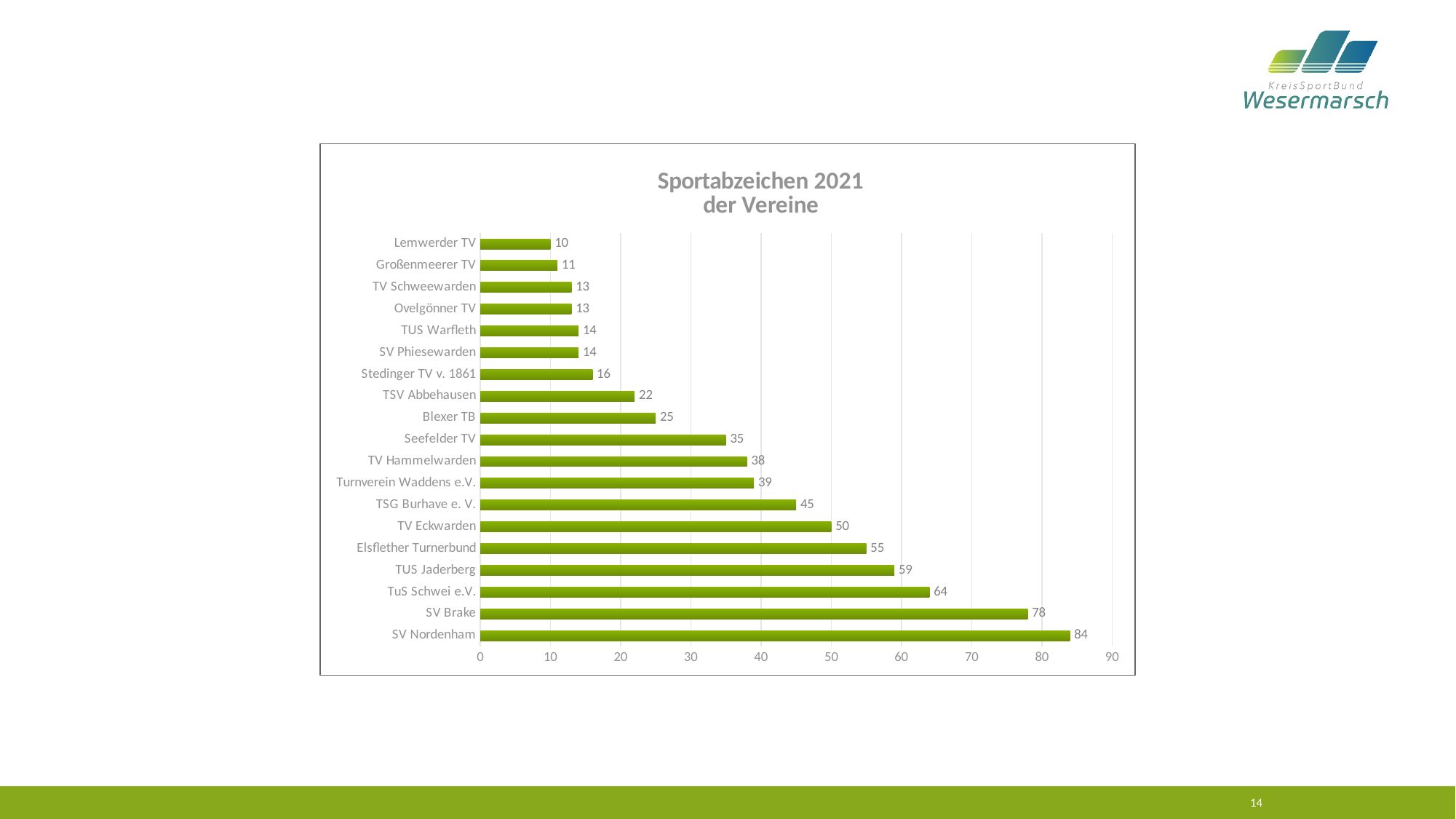
What is the value for Stedinger TV v. 1861? 16 Which club has the lowest value? Lemwerder TV Which has a larger value, Seefelder TV or Blexer TB? Seefelder TV What is the value for SV Nordenham? 84 What kind of chart is shown? bar chart Is the value for TUS Jaderberg greater or less than 50? greater How many clubs are shown in the chart? 19 Which club has the highest value? SV Nordenham What is the value for TV Eckwarden? 50 What is the title of the chart? Sportabzeichen 2021 der Vereine What is the difference between the values for Elsflether Turnerbund and TSG Burhave e. V.? 10 What is the difference between the values for SV Brake and TuS Schwei e.V.? 14